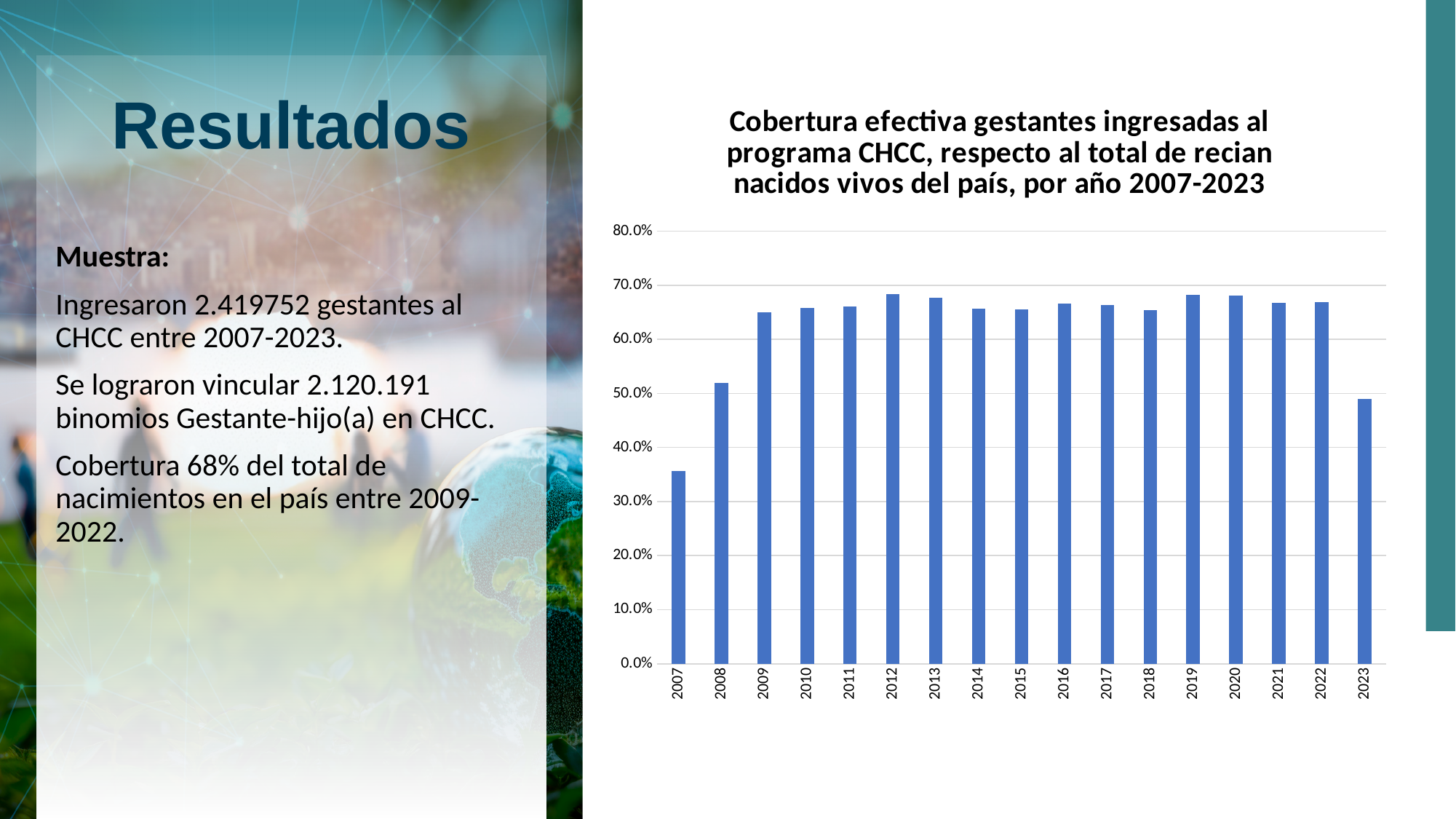
Which is larger, the value for 2023 or the value for 2009? 2009 Which year has the lowest coverage value in the chart? 2007 Is the value for 2008 greater or less than 50.0%? greater What is the highest value shown on the vertical axis of the chart? 80.0% How many years (bars) are plotted in the chart? 17 What kind of chart is shown on the slide? Bar chart Which is larger, the value for 2007 or the value for 2008? 2008 Is the value for 2023 greater or less than 40.0%? greater Do the values rise or fall from 2007 to 2009? rise Is the value for 2012 greater or less than 60.0%? greater